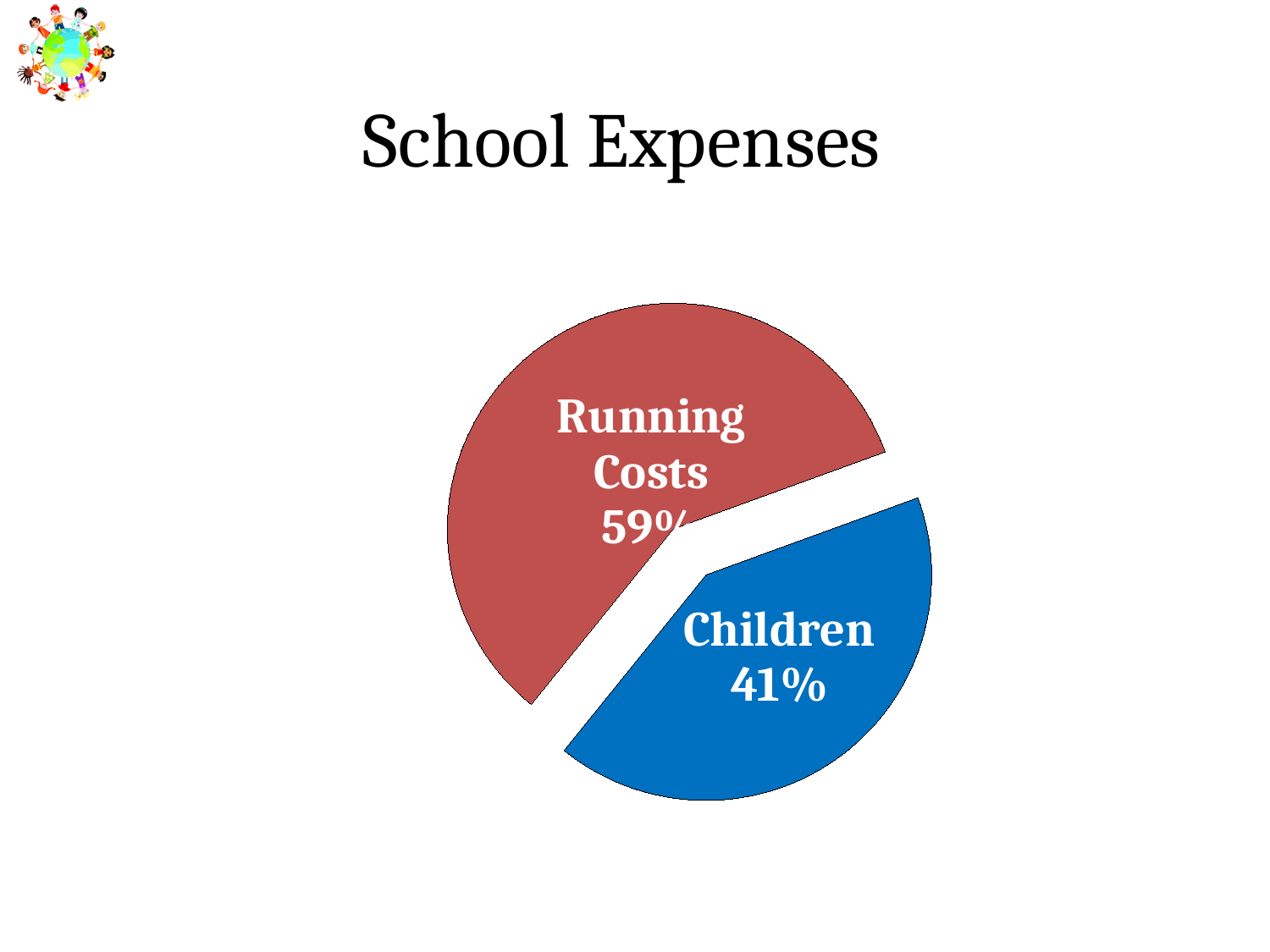
What is the total of the two slices shown in the pie chart? 100% Which slice of the pie chart is the largest? Running Costs How many slices does the pie chart have? 2 What is the title of the slide containing the chart? School Expenses What share of school expenses goes to Children? 41% Which is larger, the share for Running Costs or the share for Children? Running Costs What kind of chart is shown on the slide? Pie chart What is the difference in percentage points between the Running Costs share and the Children share? 18 Is the share for Children greater or less than 50%? less Which slice of the pie chart is the smallest? Children What colour is the Children slice of the pie chart? Blue What share of school expenses goes to Running Costs? 59%